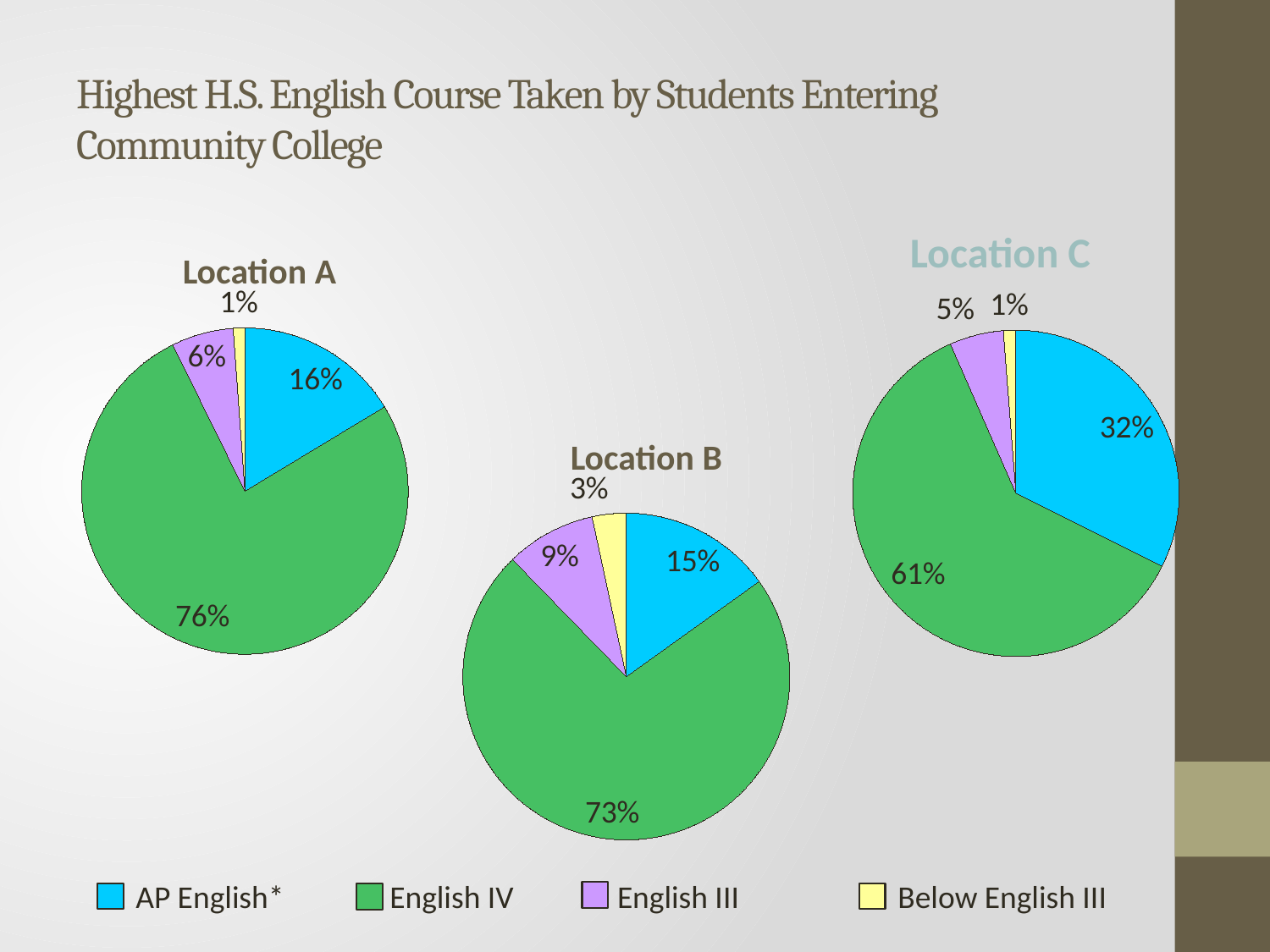
What type of chart is used for Location A, Location B and Location C? Pie chart In the Location A pie chart, what share of students had English IV as their highest course? 76% How many entries does the legend list? 4 In the Location B pie chart, which course has the largest slice? English IV In the Location C pie chart, what percentage is shown for Below English III? 1% In the Location C pie chart, what is the difference between the English IV share and the AP English share? 29% In the Location A pie chart, which course has the smallest slice? Below English III In the Location B pie chart, what percentage is shown for English III? 9% In the Location C pie chart, what percentage is shown for AP English? 32% How many slices does the Location B pie chart have? 4 Which colour represents English III in the legend? Purple Is the AP English share larger in the Location C pie chart or the Location A pie chart? Location C